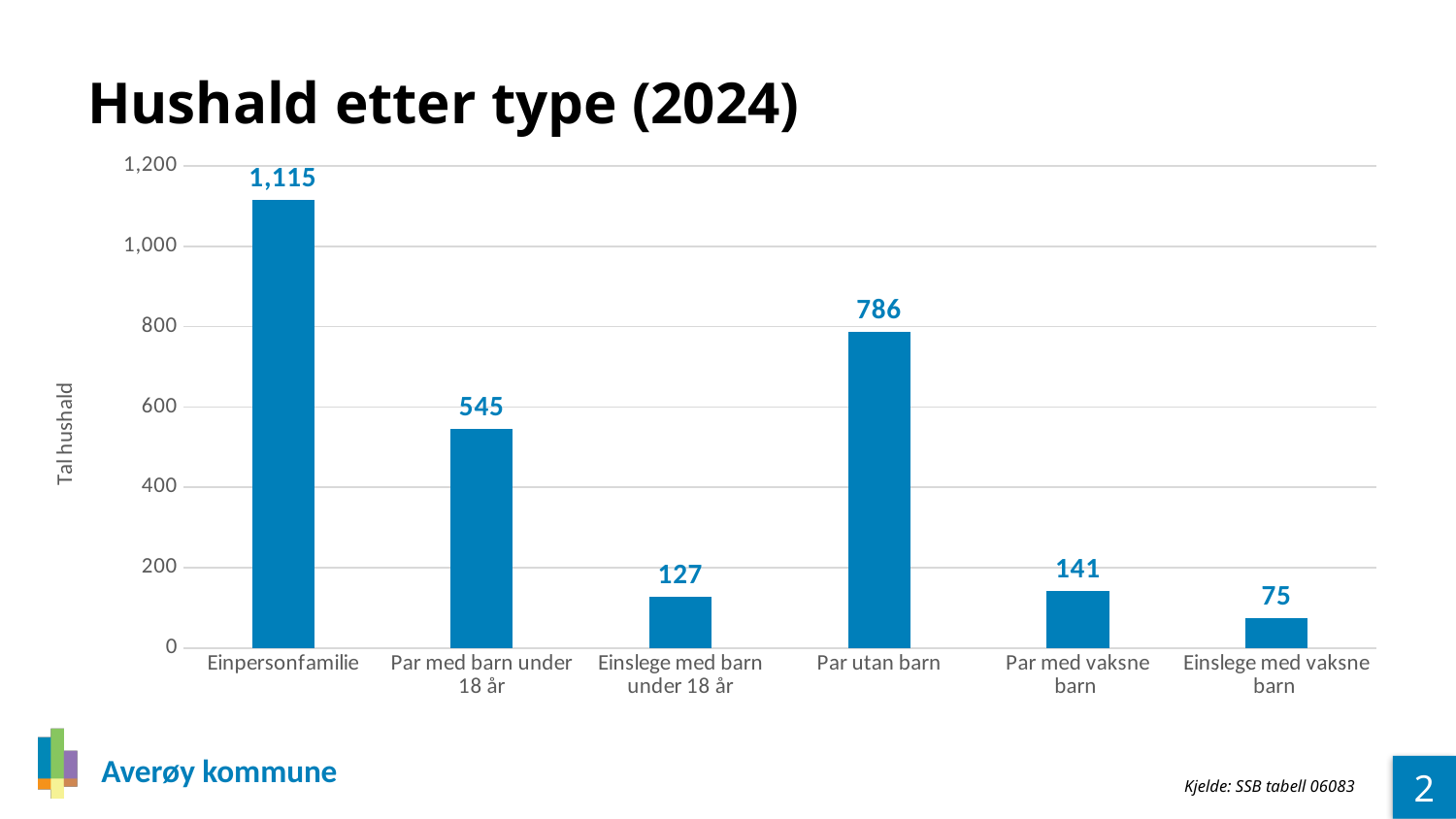
What is the value for Einslege med vaksne barn? 75 What is the difference between the values for Einpersonfamilie and Par utan barn? 329 How many categories are shown on the x axis? 6 Which is larger, the value for Par med barn under 18 år or the value for Par utan barn? Par utan barn What is the title of the chart? Hushald etter type (2024) Is the value for Par med barn under 18 år greater or less than 600? less What is the difference between the values for Par med vaksne barn and Einslege med barn under 18 år? 14 What is the value for Einpersonfamilie? 1,115 Which category has the highest value? Einpersonfamilie What kind of chart is shown on the slide? bar chart Which category has the lowest value? Einslege med vaksne barn What is the value for Par utan barn? 786